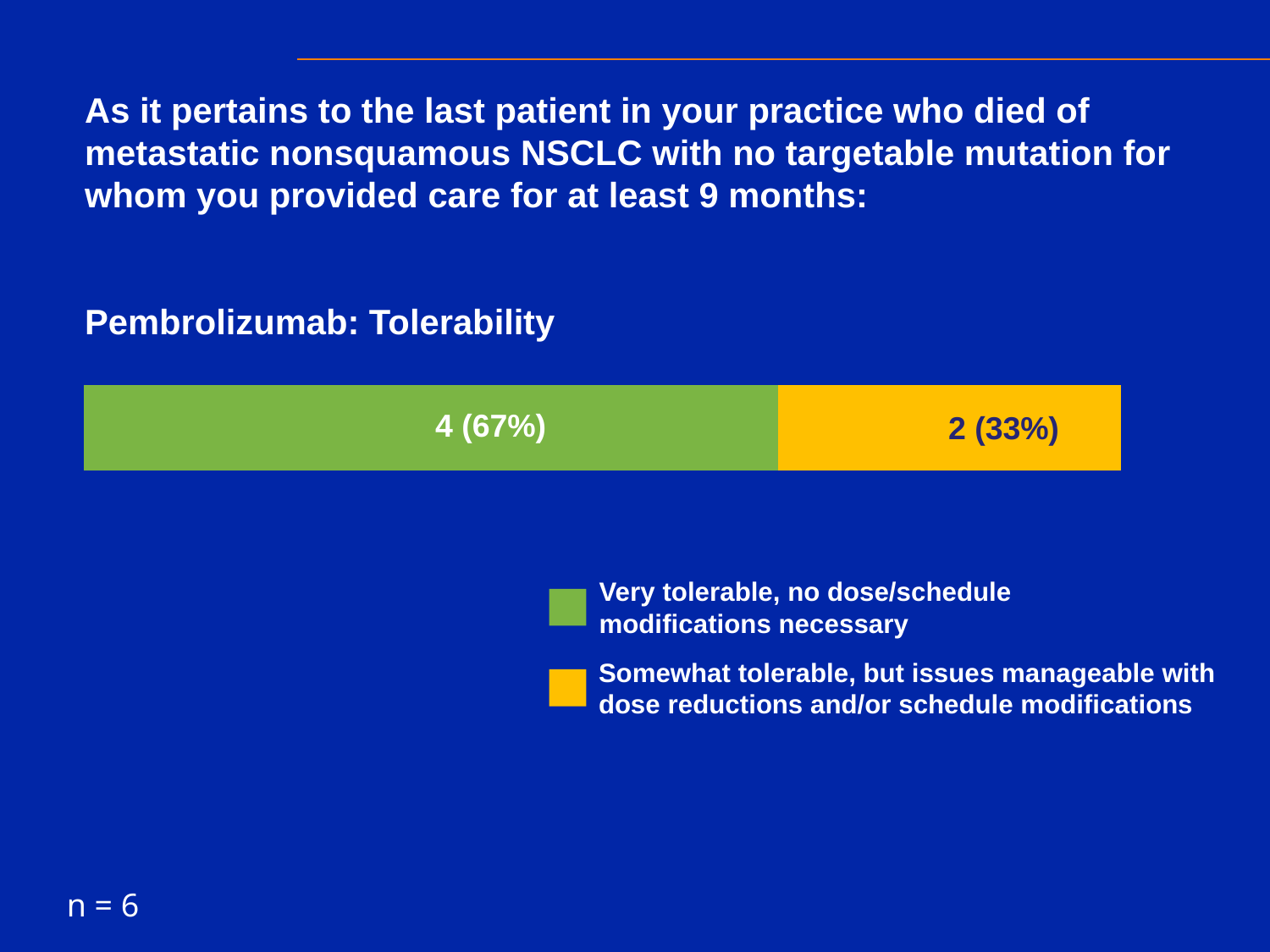
Which has more respondents: "Very tolerable, no dose/schedule modifications necessary" or "Somewhat tolerable, but issues manageable with dose reductions and/or schedule modifications"? Very tolerable, no dose/schedule modifications necessary How many respondents chose "Somewhat tolerable, but issues manageable with dose reductions and/or schedule modifications"? 2 (33%) What percentage of respondents chose "Very tolerable, no dose/schedule modifications necessary"? 67% What kind of chart is shown on the slide? Stacked bar chart What is the total number of respondents across both segments of the bar? 6 Which response option received the most respondents? Very tolerable, no dose/schedule modifications necessary What colour represents "Somewhat tolerable, but issues manageable with dose reductions and/or schedule modifications"? Yellow How many respondents chose "Very tolerable, no dose/schedule modifications necessary"? 4 (67%) How many response options does the legend list? 2 Which response option received the fewest respondents? Somewhat tolerable, but issues manageable with dose reductions and/or schedule modifications What is the difference in the number of respondents between the "Very tolerable" and "Somewhat tolerable" options? 2 What is the title of the chart? Pembrolizumab: Tolerability